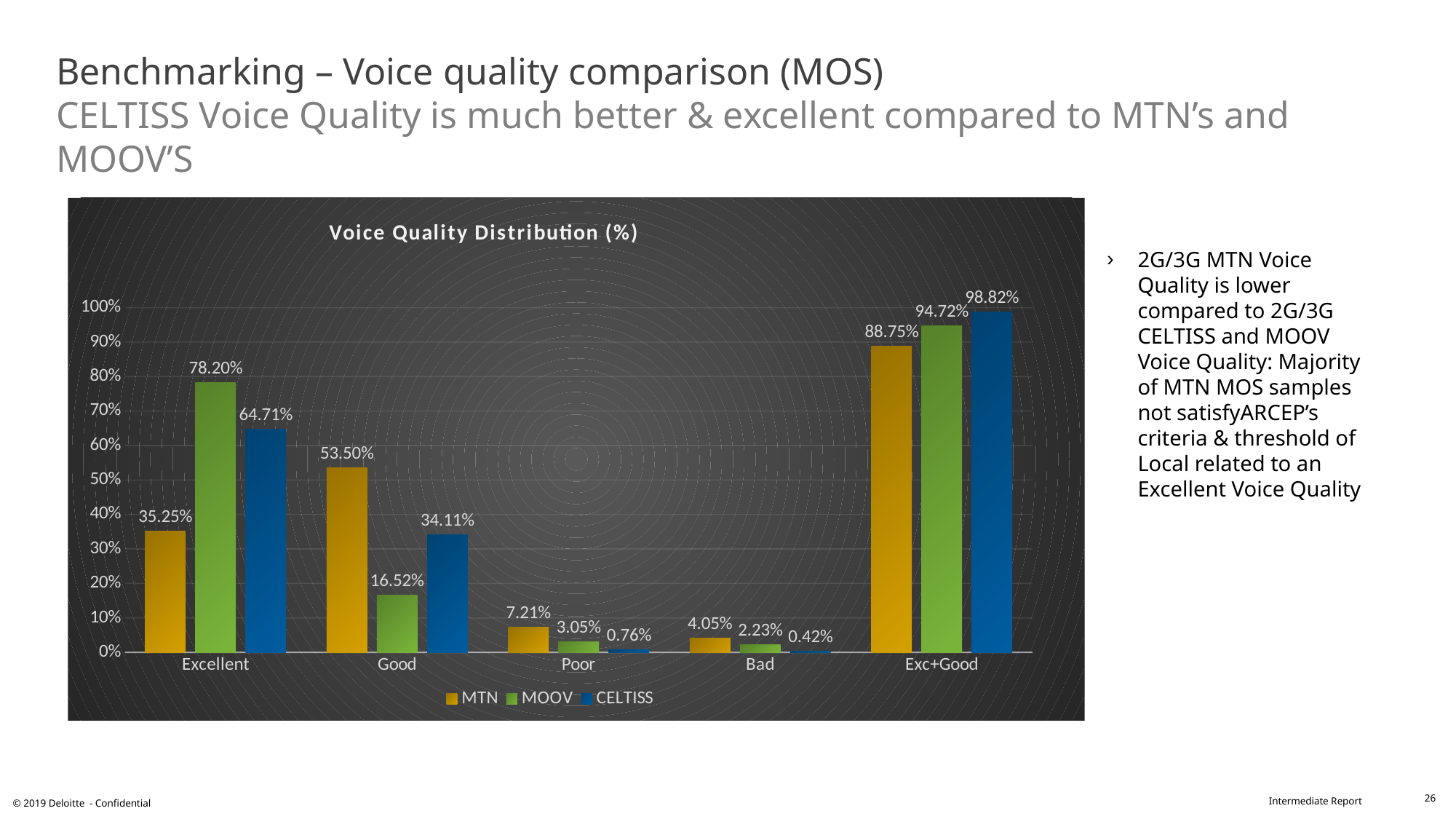
What is the MTN value for the Good category? 53.50% Which is larger: the CELTISS value for Good or the MOOV value for Good? CELTISS value for Good How many categories are shown on the x axis? 5 Which operator has the lowest value in the Bad category? CELTISS What is the MOOV value for the Excellent category? 78.20% Is the MTN value for Excellent greater or less than 40%? less What is the title of the chart? Voice Quality Distribution (%) Which operator has the highest value in the Excellent category? MOOV What is the CELTISS value for the Exc+Good category? 98.82% How many series does the legend list? 3 What is the difference between the MOOV and MTN values in the Exc+Good category? 5.97% What kind of chart is shown on the slide? Bar chart